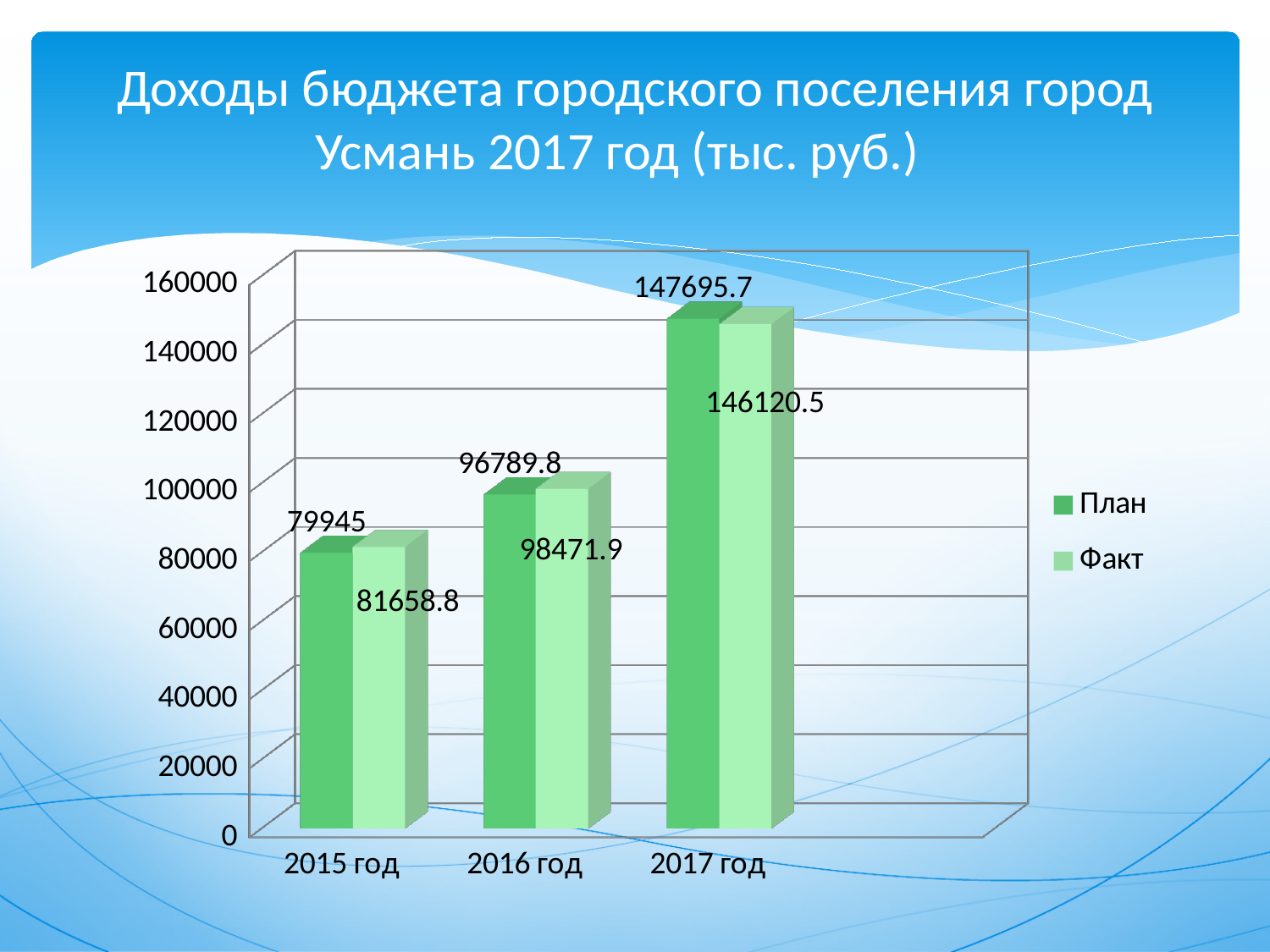
What is the План value for 2015 год? 79945 What kind of chart is shown on the slide? Bar chart Which year has the lowest План value? 2015 год What is the Факт value for 2015 год? 81658.8 What is the Факт value for 2016 год? 98471.9 Which is larger for 2016 год, План or Факт? Факт What is the План value for 2017 год? 147695.7 Which year has the highest Факт value? 2017 год Do the Факт values rise or fall from 2015 год to 2017 год? Rise How many series does the legend list? 2 How many years are shown on the x axis? 3 What is the difference between the План and Факт values for 2017 год? 1575.2